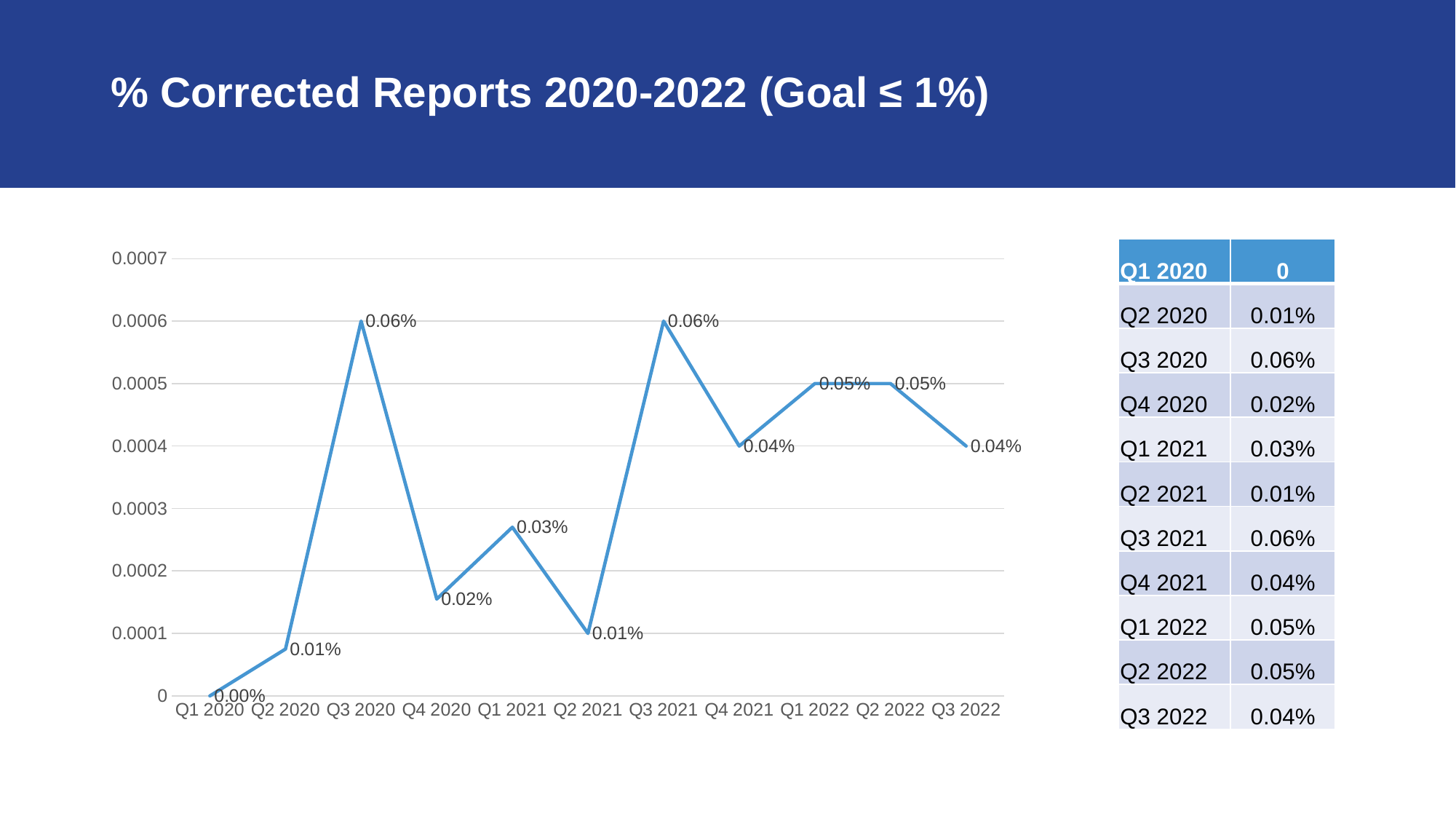
What is the value for Q2 2021? 0.01% What is the difference between the values for Q1 2021 and Q2 2021? 0.02% What is the value for Q3 2020? 0.06% How many quarters are plotted on the chart? 11 What kind of chart is shown on the slide? Line chart What is the title of the slide? % Corrected Reports 2020-2022 (Goal ≤ 1%) Which is larger, the value for Q4 2021 or the value for Q1 2022? Q1 2022 What is the value for Q3 2022? 0.04% Do the values rise or fall from Q1 2020 to Q3 2020? Rise What is the value for Q1 2021? 0.03% Which quarter has the lowest value? Q1 2020 What is the difference between the values for Q3 2020 and Q4 2020? 0.04%